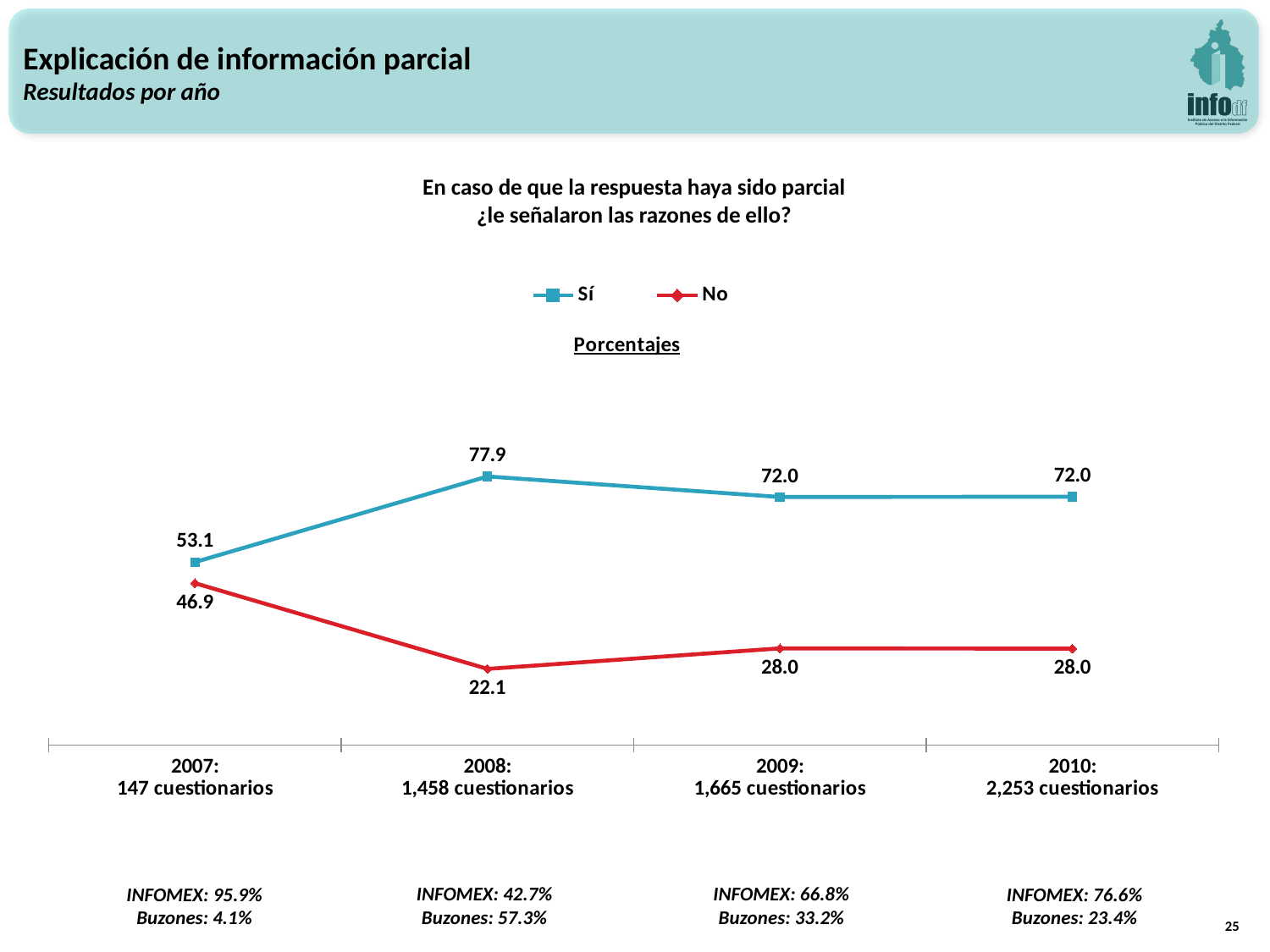
Which is larger in 2007, Sí or No? Sí How many series does the legend list? 2 How many cuestionarios are indicated for 2010 on the x axis? 2,253 cuestionarios How many years are shown on the x axis? 4 What is the value for No in 2010? 28.0 Does the No series rise or fall from 2007 to 2008? Fall What kind of chart is this? Line chart What is the difference between Sí and No in 2009? 44.0 In which year is the No series lowest? 2008 What is the value for Sí in 2008? 77.9 What is the value for No in 2007? 46.9 In which year is the Sí series highest? 2008